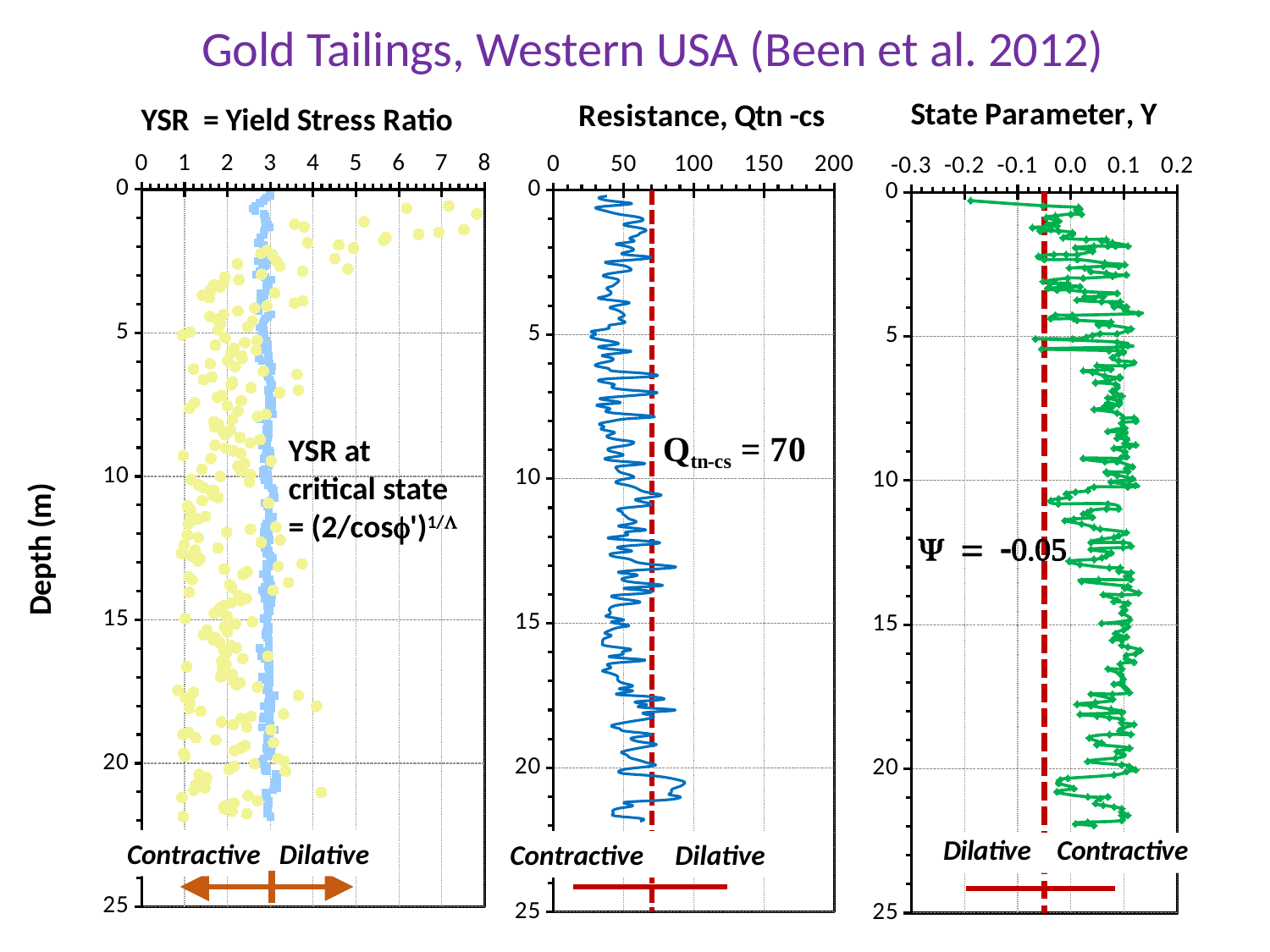
In the Resistance, Qtn-cs chart, what value does the red dashed reference line mark? 70 What is the maximum depth shown on the vertical axis of the three charts? 25 What is the title of the slide? Gold Tailings, Western USA (Been et al. 2012) What is the label of the shared vertical axis of the charts? Depth (m) In the State Parameter chart, is the green line at a depth of 15 m greater or less than 0.0? greater In the YSR = Yield Stress Ratio chart, is the blue critical-state line at a depth of 10 m greater or less than 4? less In the State Parameter chart, what value does the red dashed reference line mark? -0.05 How many charts are shown on the slide? 3 In the YSR = Yield Stress Ratio chart, is the blue critical-state line at a depth of 20 m greater or less than 2? greater What is the largest value shown on the horizontal axis of the Resistance, Qtn-cs chart? 200 What kind of chart is the Resistance, Qtn-cs chart? line chart